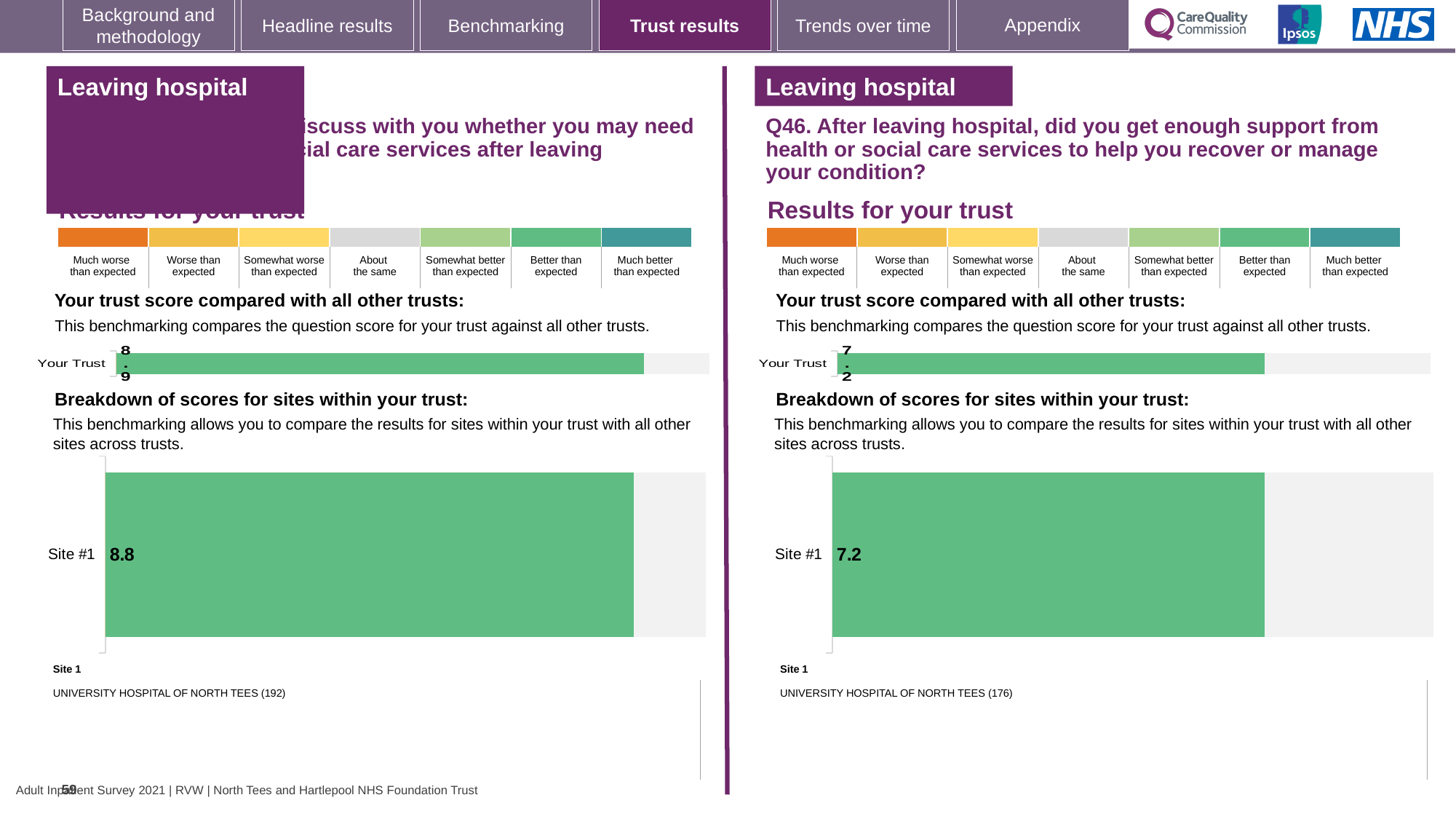
How many sites are shown in the site breakdown chart on the right-hand side for Q46? 1 On the right-hand side for Q46, which site is listed as Site 1? UNIVERSITY HOSPITAL OF NORTH TEES (176) On the left-hand site breakdown chart, what is the score for Site #1? 8.8 Which is larger: the Your Trust score on the left-hand chart or the Your Trust score on the right-hand chart for Q46? Left-hand chart (8.9) On the right-hand site breakdown chart for Q46, what is the score for Site #1? 7.2 What is the difference between the Site #1 score on the left-hand chart and the Site #1 score on the right-hand chart for Q46? 1.6 On the right-hand chart for Q46, what is the score shown for Your Trust? 7.2 What type of chart is used to show the Site #1 score on the left-hand side? Bar chart Is the Your Trust score on the left-hand chart greater or less than the Site #1 score on the same side? Greater What is the difference between the Your Trust score and the Site #1 score on the left-hand charts? 0.1 What colour is the Your Trust bar on the right-hand chart for Q46? Green On the left-hand chart, what is the score shown for Your Trust? 8.9